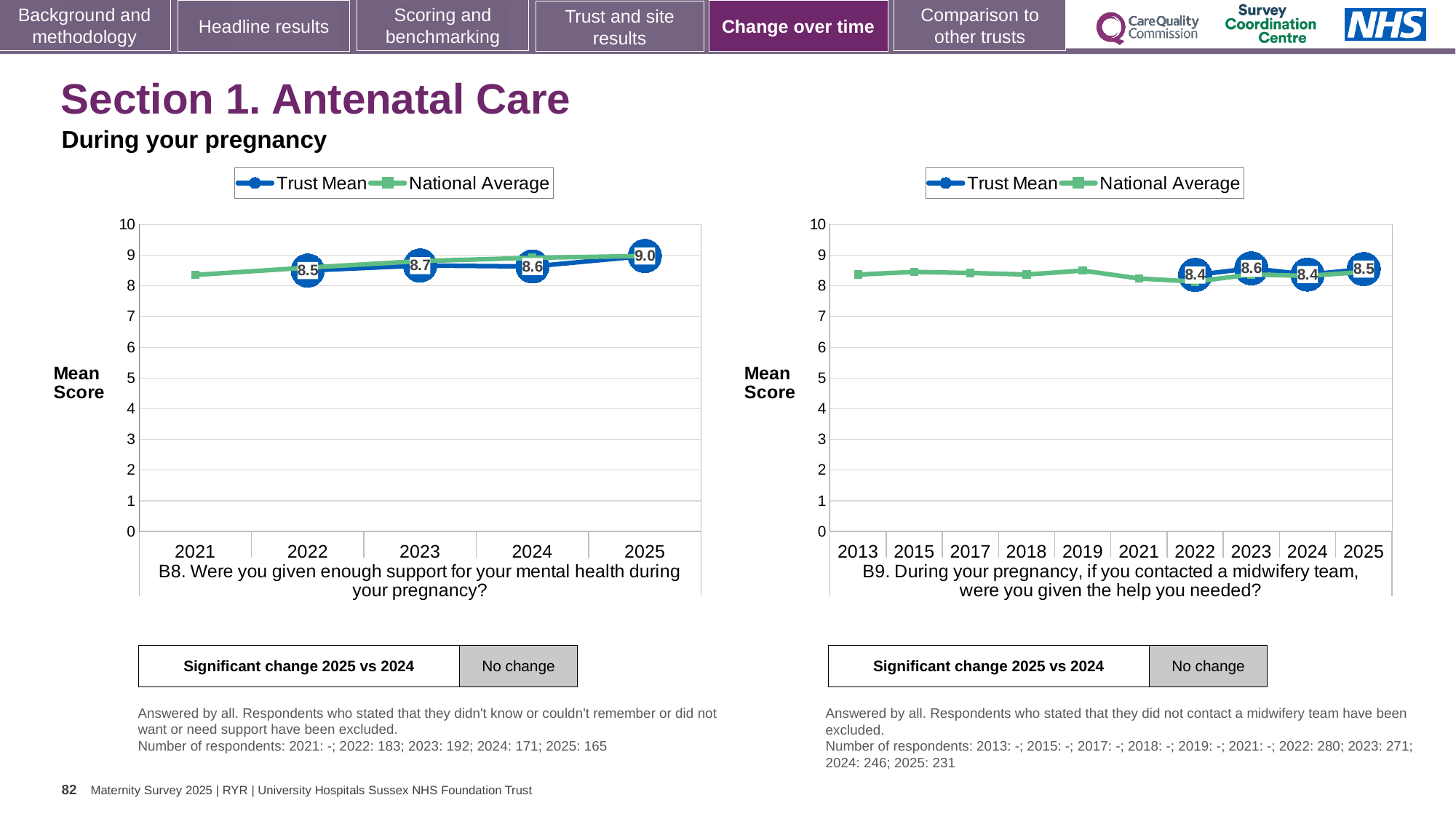
In the B8 chart (left), which year has the highest Trust Mean? 2025 How many series does the legend of the B8 chart (left) list? 2 In the B8 chart (left), what is the Trust Mean for 2025? 9.0 What kind of chart is the B9 chart (right)? Line chart In the B9 chart (right), what is the Trust Mean for 2023? 8.6 In the B8 chart (left), what is the difference between the Trust Mean in 2025 and in 2024? 0.4 In the B8 chart (left), what is the Trust Mean for 2022? 8.5 In the B9 chart (right), what is the Trust Mean for 2025? 8.5 In the B9 chart (right), is the National Average for 2013 greater or less than 5? greater In the B9 chart (right), how many years are shown on the x axis? 10 In the B8 chart (left), how many years are shown on the x axis? 5 In the B9 chart (right), which year has the highest labelled Trust Mean? 2023